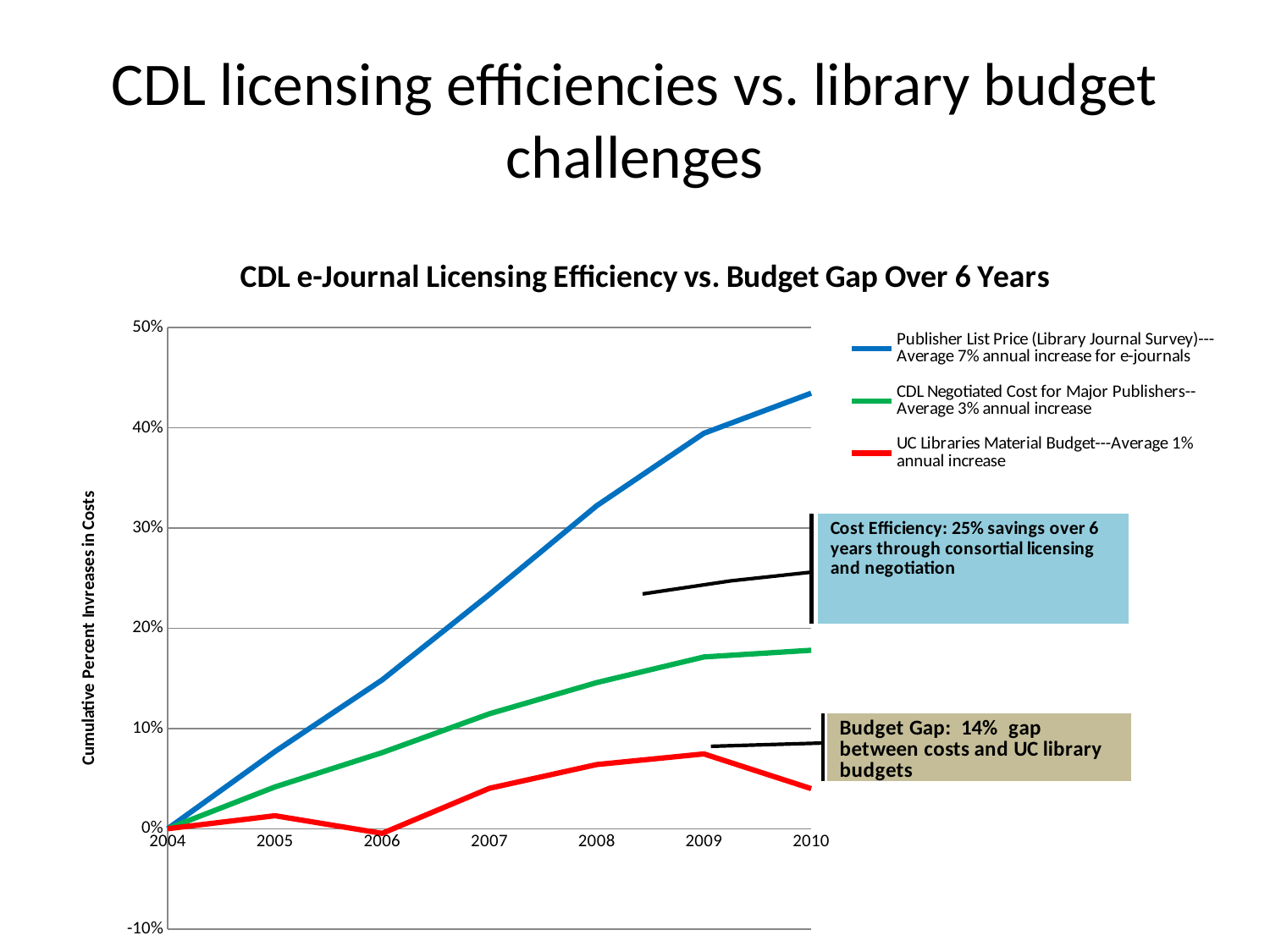
How many series does the chart legend list? 3 Which series has the highest value in 2010? Publisher List Price (Library Journal Survey) What kind of chart is shown on the slide? line chart Does the Publisher List Price series rise or fall from 2004 to 2010? rise What is the title of the chart? CDL e-Journal Licensing Efficiency vs. Budget Gap Over 6 Years Which series has the lowest value in 2010? UC Libraries Material Budget How many years are plotted along the x axis of the chart? 7 Is the value for Publisher List Price in 2010 greater or less than 40%? greater In 2009, which is larger: the CDL Negotiated Cost for Major Publishers or the UC Libraries Material Budget? CDL Negotiated Cost for Major Publishers Is the value for UC Libraries Material Budget in 2010 greater or less than 10%? less Is the value for CDL Negotiated Cost for Major Publishers in 2010 greater or less than 20%? less What is the value of the Publisher List Price series in 2004? 0%